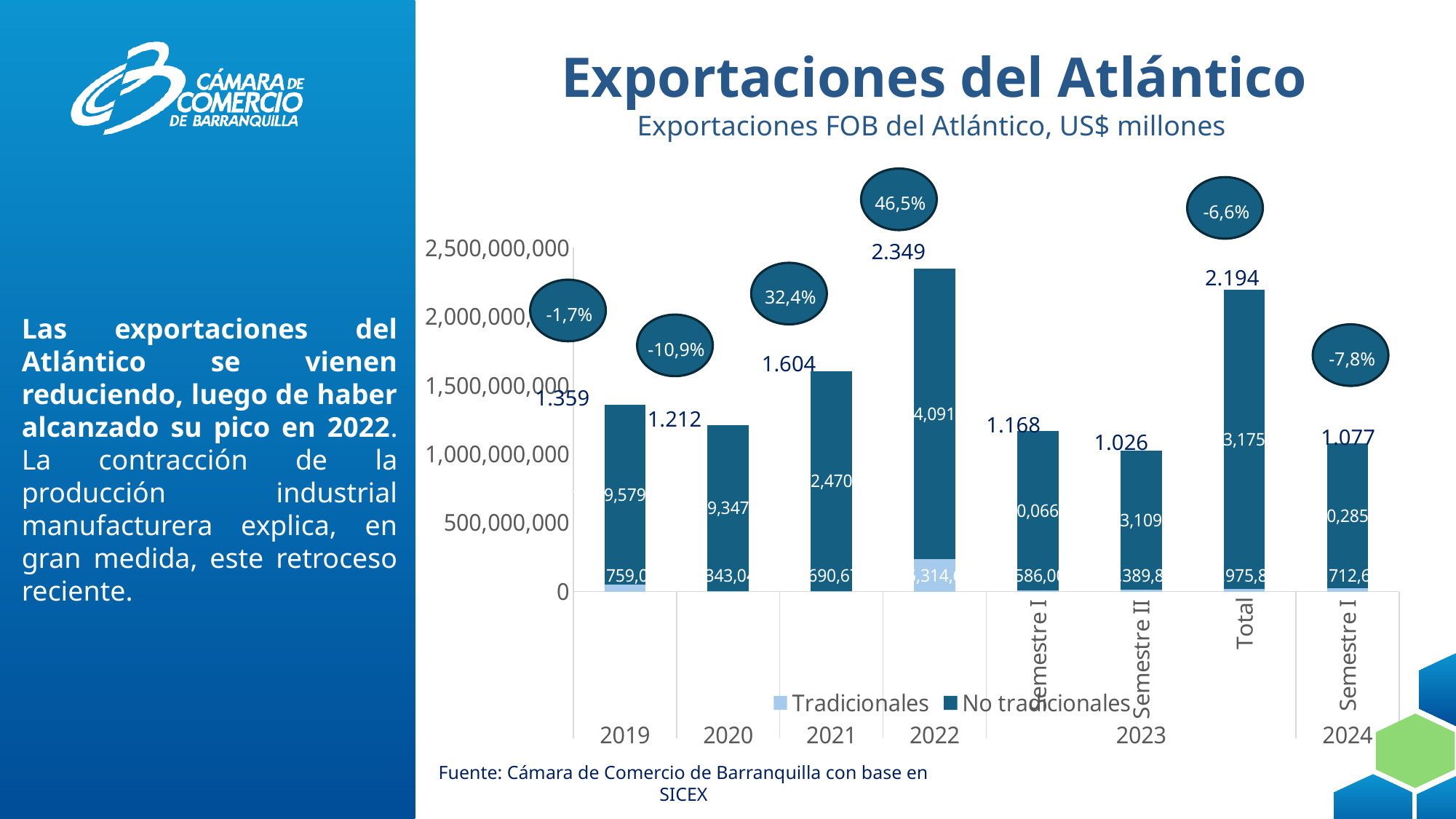
What kind of chart is shown on the slide? bar chart Which bar has the highest total value? 2022 What is the difference between the total for 2022 and the total for 2021, in US$ millions? 745 Which total is larger, 2019 or 2020? 2019 Which bar has the lowest total value? 2023 Semestre II Do the total values rise or fall from 2020 to 2022? rise What percentage change is shown in the bubble above the 2024 Semestre I bar? -7,8% How many series does the legend list? 2 What is the total value labelled above the bar for 2022? 2.349 What is the total value labelled above the bar for 2021? 1.604 What percentage change is shown in the bubble above the 2022 bar? 46,5% Is the bar for 2023 Total greater or less than 2,000,000,000? greater